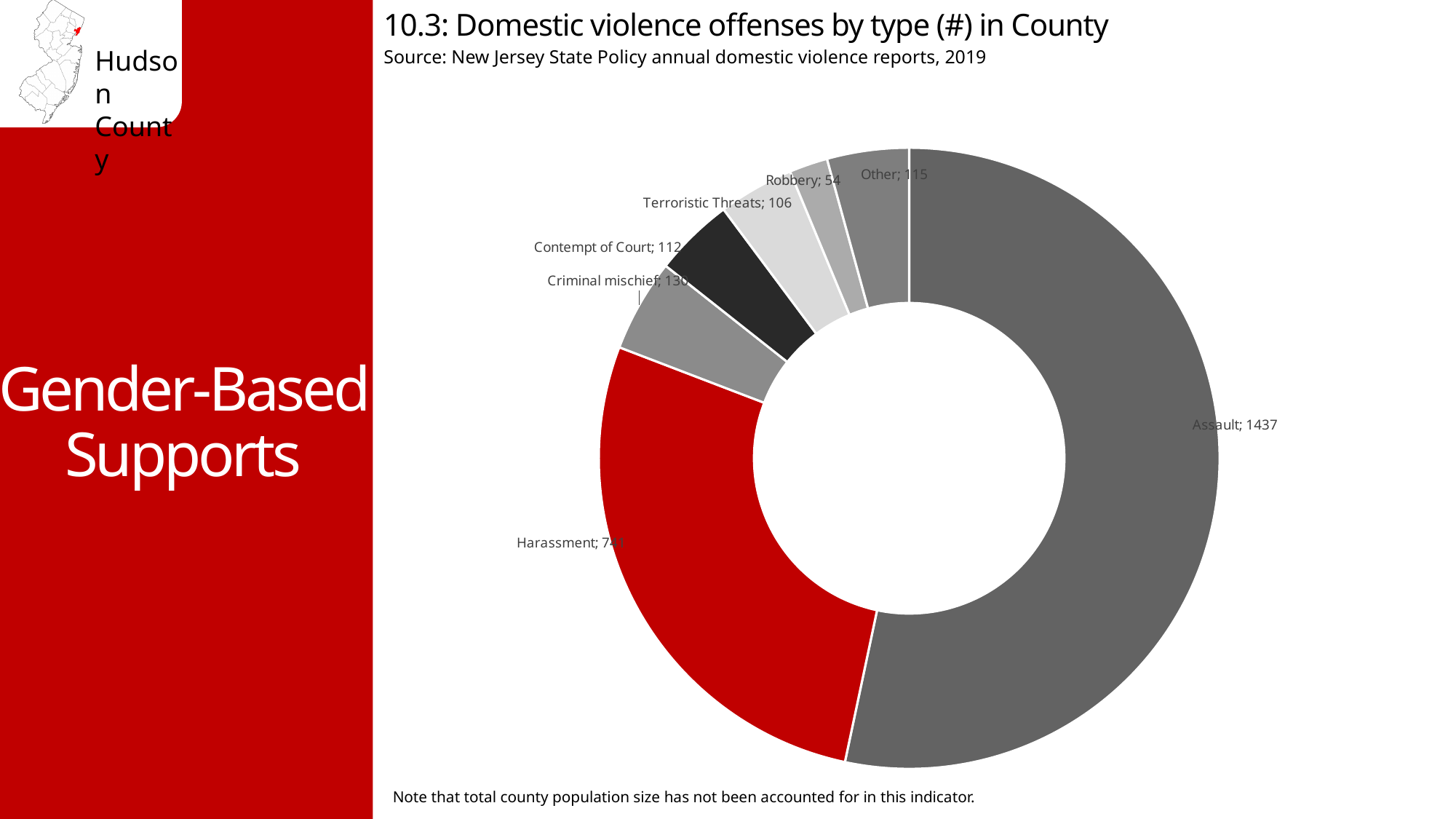
Which offense type has the lowest number of domestic violence offenses? Robbery How many domestic violence offenses are recorded for Robbery? 54 What is the difference between the number of Assault offenses and the number of Other offenses? 1322 How many domestic violence offenses are recorded for Contempt of Court? 112 How many domestic violence offenses are recorded for Assault? 1437 How many domestic violence offenses are recorded for Other? 115 What is the source cited for the chart? New Jersey State Policy annual domestic violence reports, 2019 How many offense types are shown in the chart? 7 Which offense type has the highest number of domestic violence offenses? Assault What kind of chart is shown on the slide? Doughnut (pie) chart Which is larger, the number of Assault offenses or the number of Harassment offenses? Assault How many domestic violence offenses are recorded for Terroristic Threats? 106